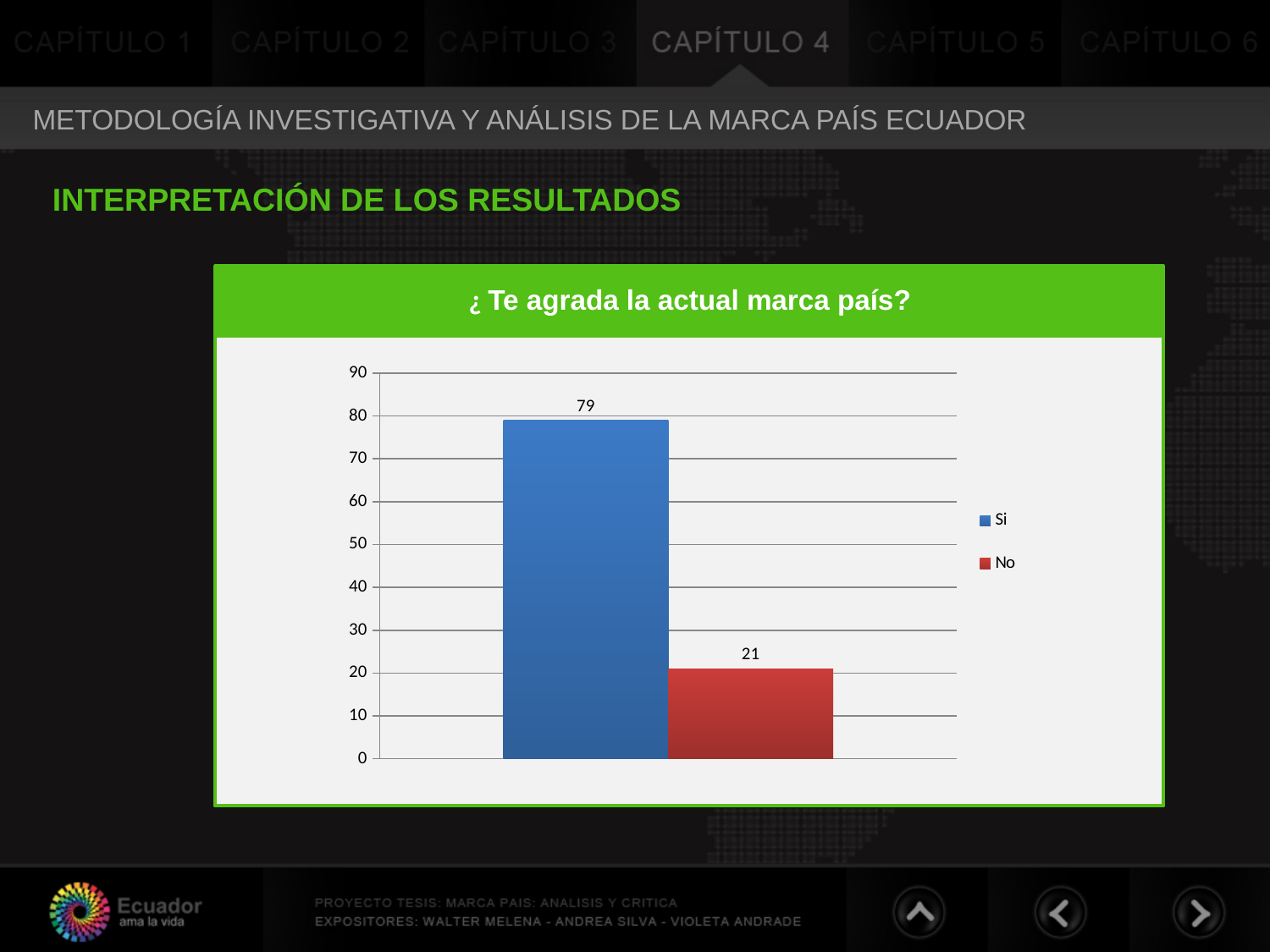
What is the title of the chart? ¿ Te agrada la actual marca país? Which series has the lowest value? No Is the value for "Si" greater or less than 70? greater Which series has the highest value? Si What is the value for "Si"? 79 What is the value for "No"? 21 How many series does the legend list? 2 Which is larger, the value for "Si" or the value for "No"? Si Is the value for "No" greater or less than 30? less What kind of chart is shown on the slide? bar chart What is the difference between the values for "Si" and "No"? 58 What colour is the bar for "No"? red